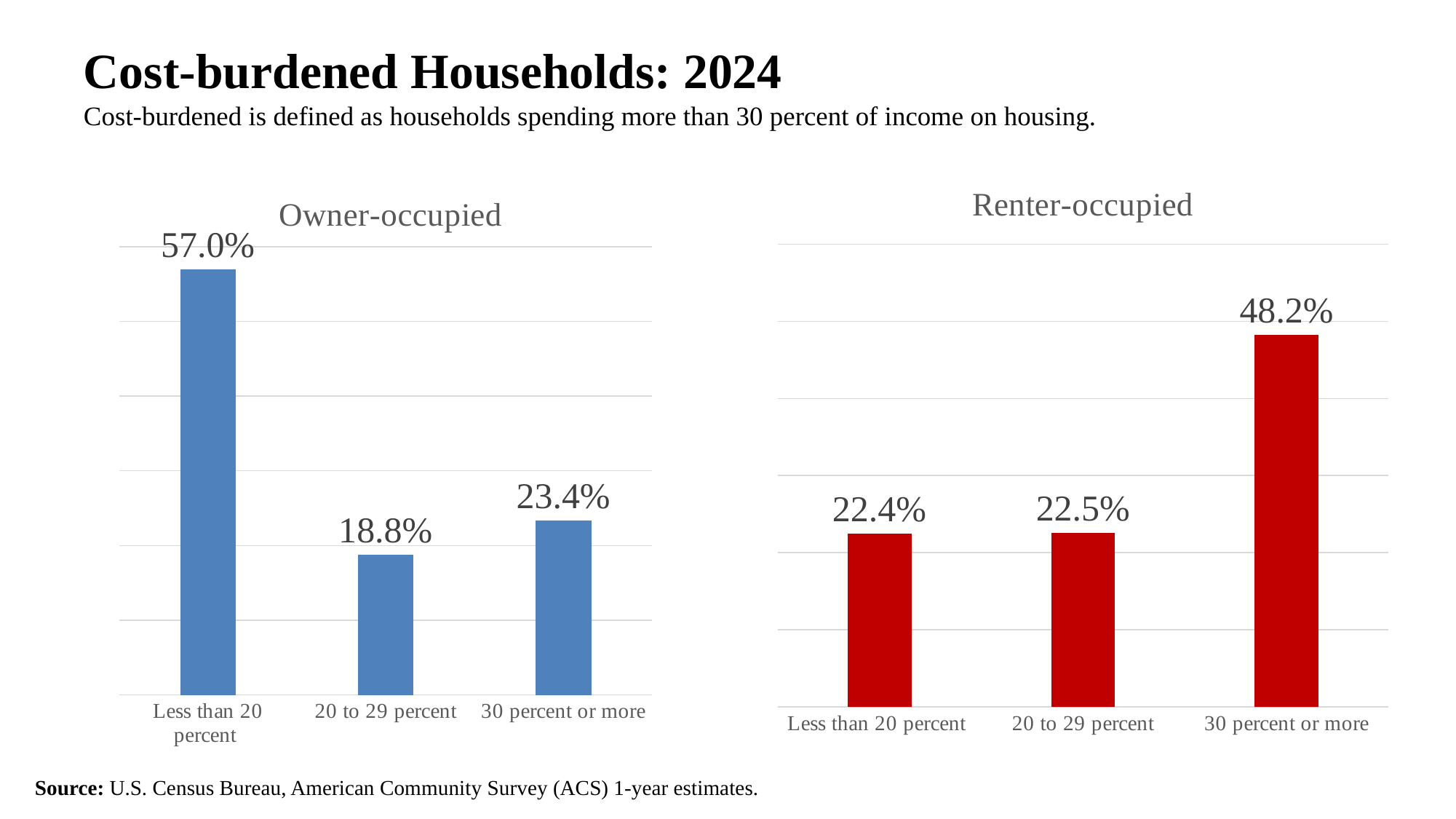
In the Renter-occupied chart, which category has the highest value? 30 percent or more In the Renter-occupied chart, what is the difference between the values for '30 percent or more' and '20 to 29 percent'? 25.7% In the Renter-occupied chart, what is the value for '30 percent or more'? 48.2% Which is larger: the '30 percent or more' value in the Owner-occupied chart or the '30 percent or more' value in the Renter-occupied chart? Renter-occupied What type of chart is the Owner-occupied chart? Bar chart How many categories are shown in the Renter-occupied chart? 3 In the Owner-occupied chart, what is the difference between the values for 'Less than 20 percent' and '30 percent or more'? 33.6% In the Owner-occupied chart, what is the value for '20 to 29 percent'? 18.8% In the Owner-occupied chart, which category has the lowest value? 20 to 29 percent In the Renter-occupied chart, what is the value for 'Less than 20 percent'? 22.4% In the Owner-occupied chart, which category has the highest value? Less than 20 percent In the Owner-occupied chart, what is the value for 'Less than 20 percent'? 57.0%